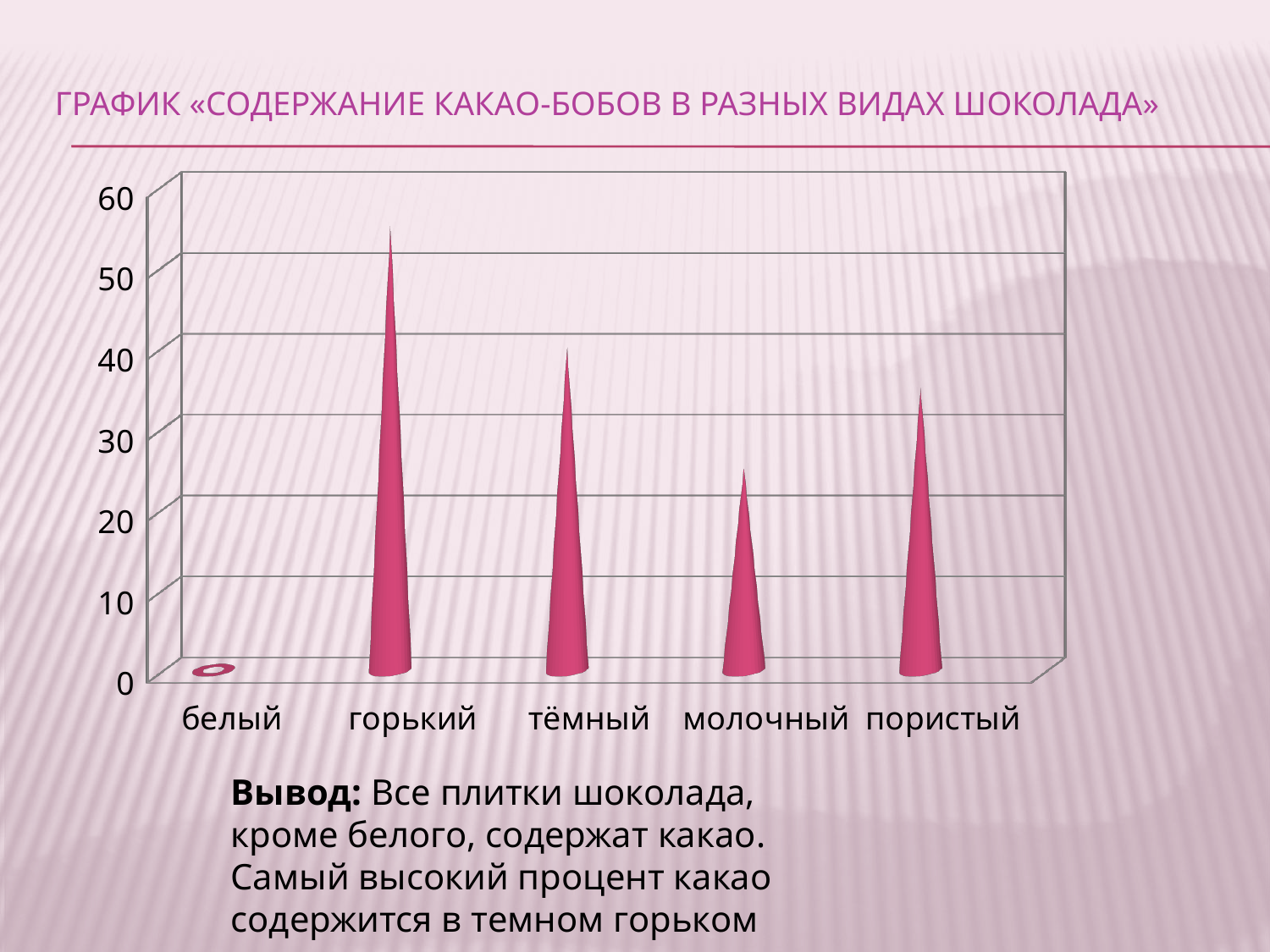
What type of chart is shown on the slide? bar chart Which type of chocolate has the lowest cocoa content in the chart? белый Is the value for молочный greater or less than 30? less What is the title of the chart on the slide? ГРАФИК «СОДЕРЖАНИЕ КАКАО-БОБОВ В РАЗНЫХ ВИДАХ ШОКОЛАДА» Is the value for тёмный greater or less than 30? greater Is the value for горький greater or less than 50? greater Which type of chocolate has the highest cocoa content in the chart? горький Which has a higher value in the chart, пористый or молочный? пористый Which has a higher value in the chart, горький or тёмный? горький What is the value shown for белый in the chart? 0 How many types of chocolate are shown on the x axis of the chart? 5